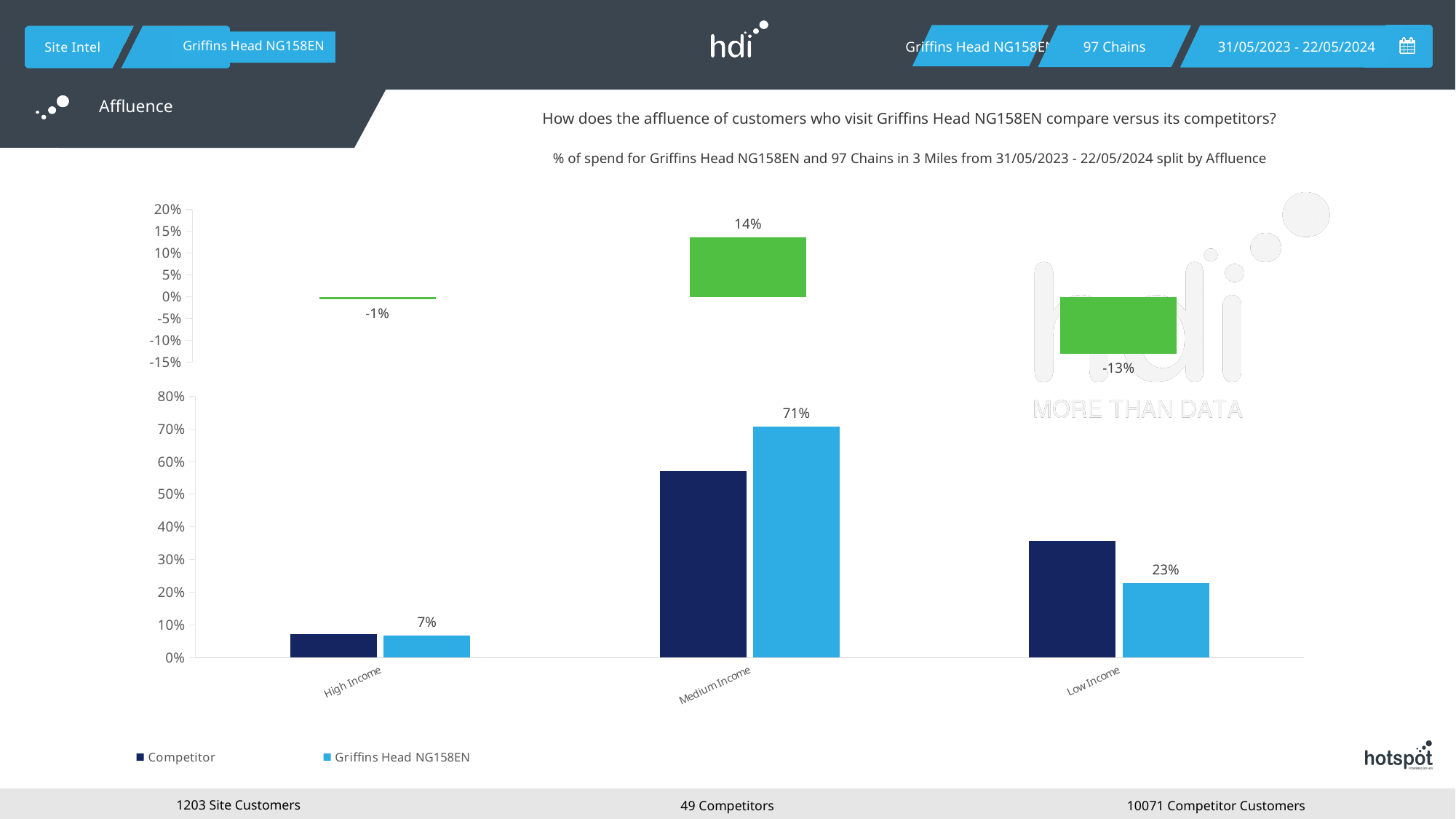
In the bottom bar chart, is the Competitor value for Medium Income greater or less than 50%? greater What type of chart is the bottom chart? Bar chart In the bottom bar chart, which is larger for Low Income: Competitor or Griffins Head NG158EN? Competitor In the bottom bar chart, what is the value for Griffins Head NG158EN in the High Income category? 7% In the top chart, what is the value shown for Medium Income? 14% In the bottom bar chart, which category has the highest value for Griffins Head NG158EN? Medium Income In the bottom bar chart, what is the value for Griffins Head NG158EN in the Low Income category? 23% In the top chart, what is the value shown for Low Income? -13% In the top chart, which category has the lowest value? Low Income How many series does the legend of the bottom bar chart list? 2 In the bottom bar chart, what is the difference between the Griffins Head NG158EN values for Medium Income and Low Income? 48% In the bottom bar chart, what is the value for Griffins Head NG158EN in the Medium Income category? 71%